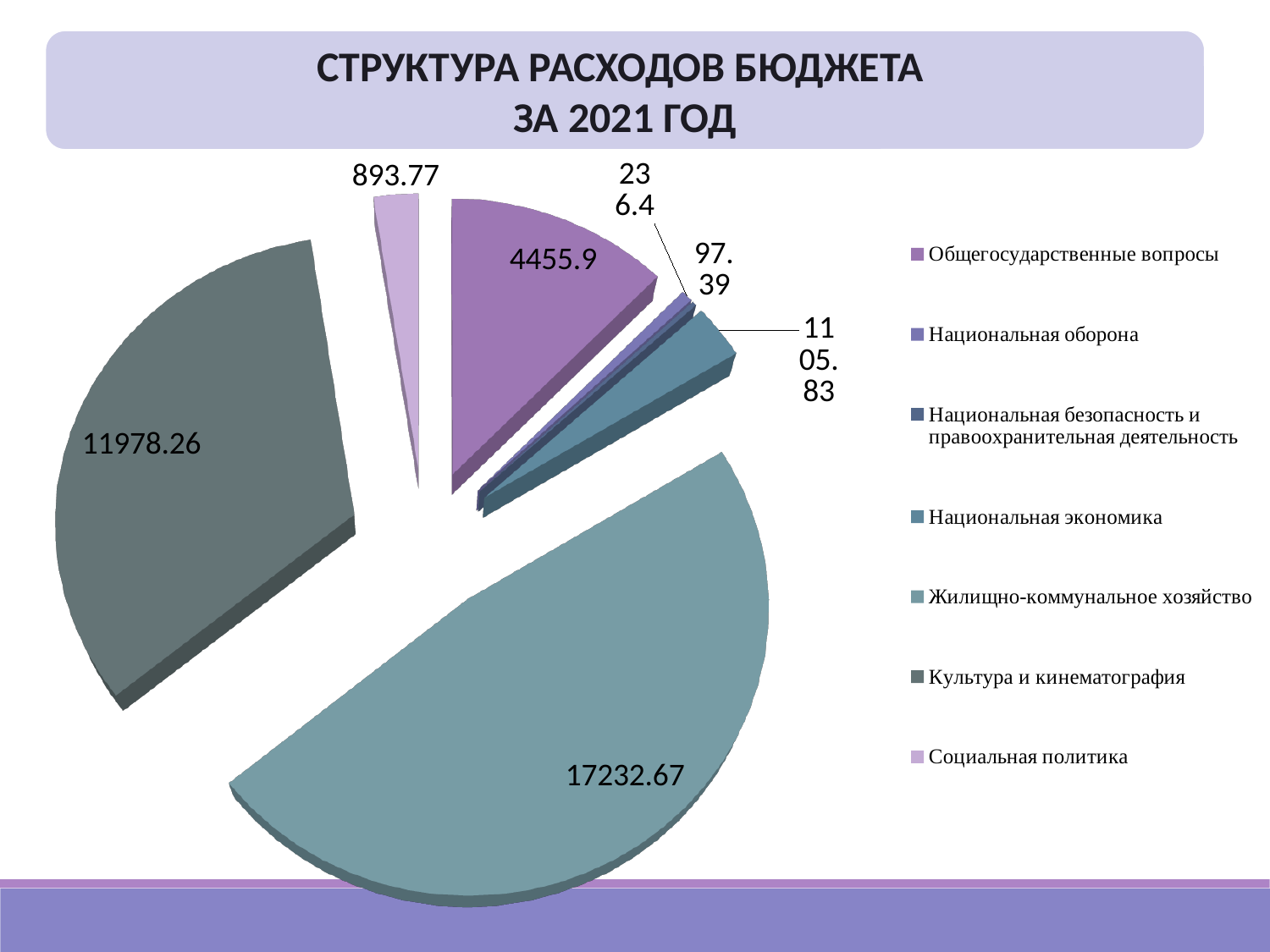
What type of chart is shown on the slide? Pie chart How many categories does the legend of the pie chart list? 7 Which category has the largest slice of the pie? Жилищно-коммунальное хозяйство What is the difference between the values for Жилищно-коммунальное хозяйство and Культура и кинематография? 5254.41 What is the value for Национальная экономика? 1105.83 Which category has the smallest slice of the pie? Национальная безопасность и правоохранительная деятельность What is the value for Социальная политика? 893.77 What is the value for Общегосударственные вопросы? 4455.9 What is the title of the chart on the slide? СТРУКТУРА РАСХОДОВ БЮДЖЕТА ЗА 2021 ГОД Which is larger, the value for Общегосударственные вопросы or the value for Социальная политика? Общегосударственные вопросы What is the value for Жилищно-коммунальное хозяйство? 17232.67 What is the value for Культура и кинематография? 11978.26